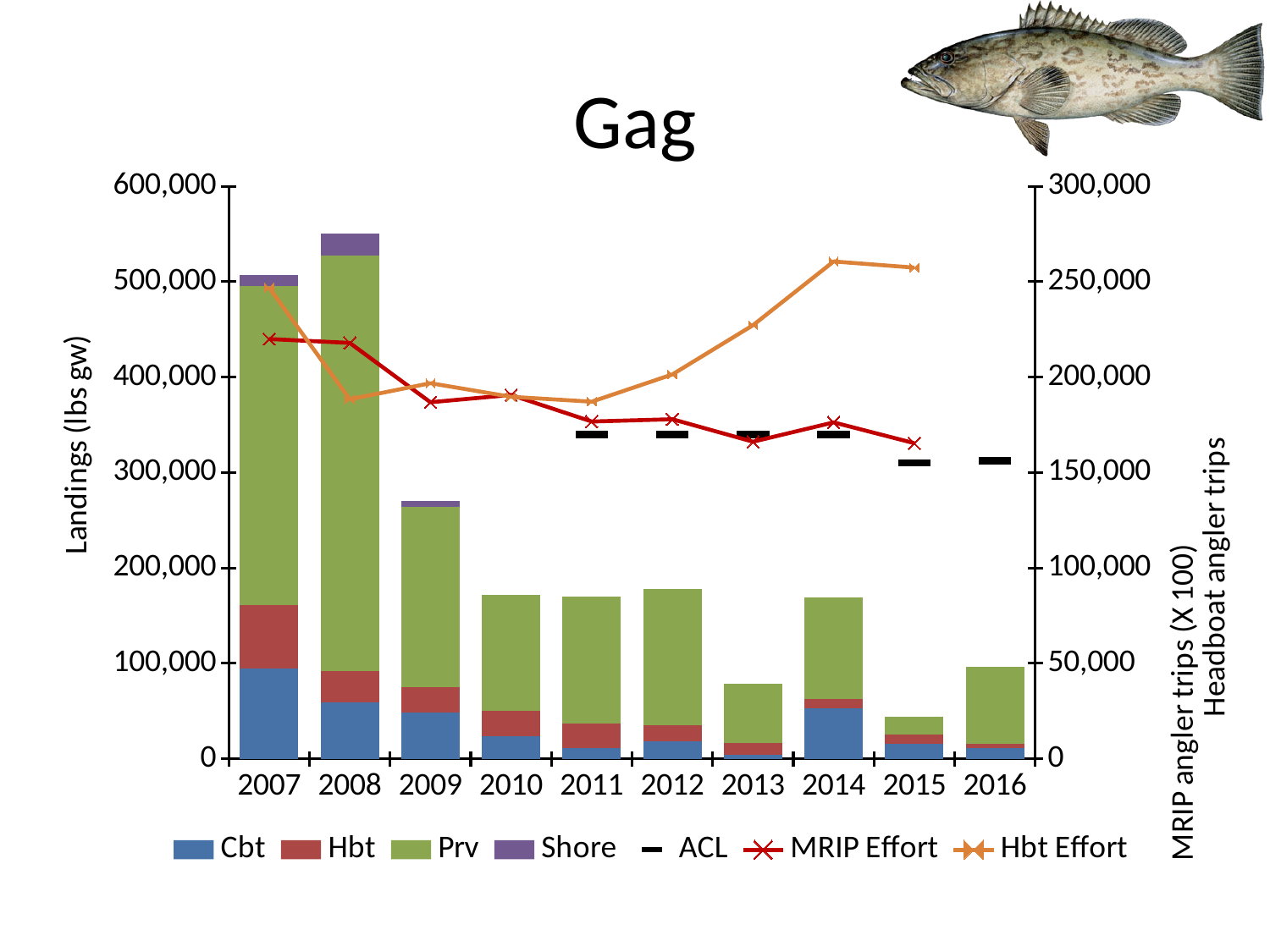
Is the total landings bar for 2013 greater or less than 100,000? less What is the title of the chart? Gag Which year has the highest total landings bar? 2008 Is the total landings bar for 2008 greater or less than 500,000? greater What kind of chart is this? Combined stacked bar and line chart Which year has the lowest total landings bar? 2015 Is the Hbt Effort value for 2014 greater or less than 250,000 on the right axis? greater Which year has the largest Cbt segment? 2007 How many years are shown on the x axis? 10 Does the Hbt Effort line rise or fall from 2011 to 2014? rise In 2014, which is larger, Hbt Effort or MRIP Effort? Hbt Effort How many entries does the chart legend list? 7